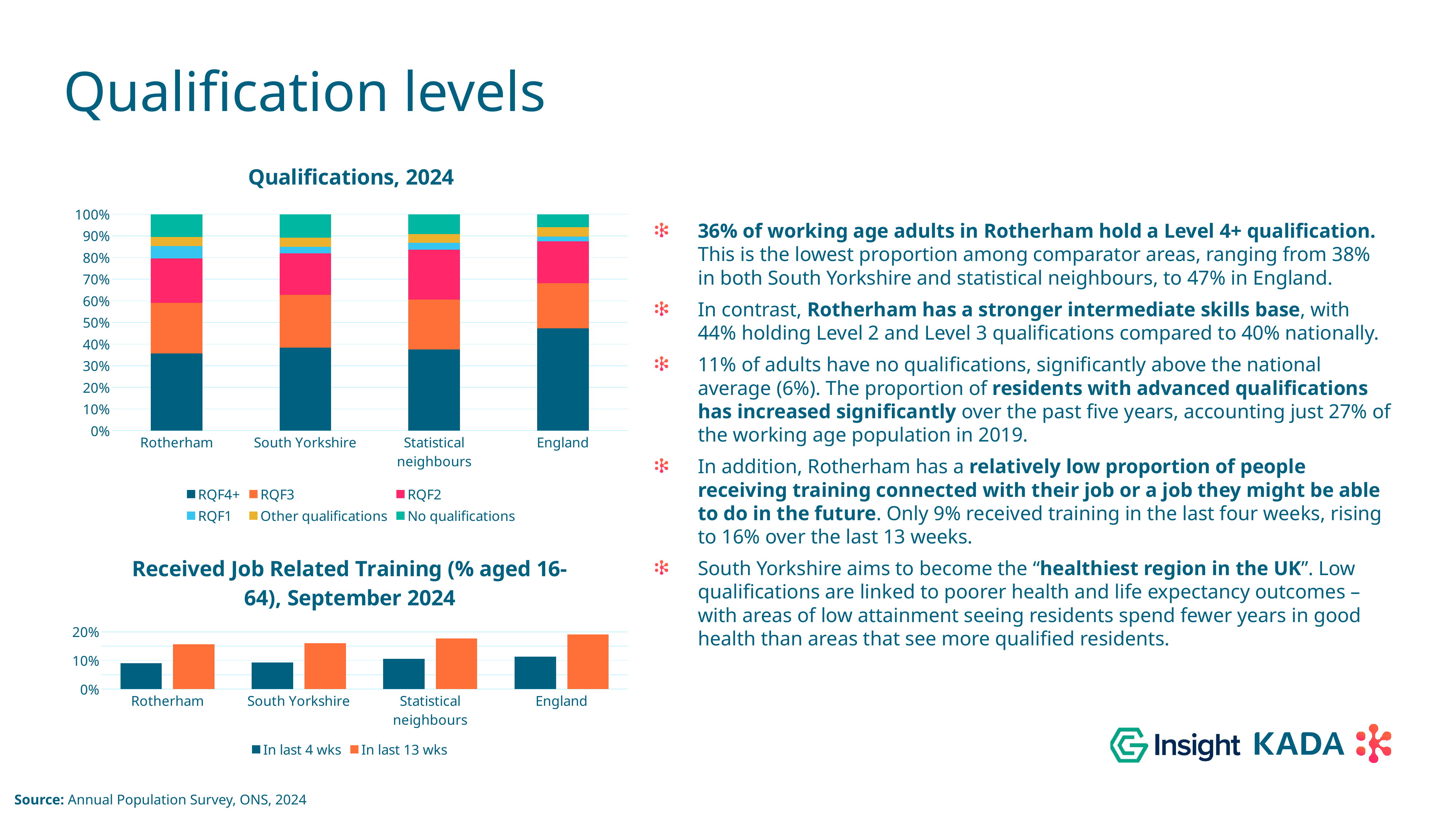
In the 'Received Job Related Training' chart, is the 'In last 4 wks' value for Rotherham greater or less than 10%? less In the 'Received Job Related Training' chart, do the 'In last 13 wks' values rise or fall from Rotherham to England? rise What kind of chart is the 'Qualifications, 2024' chart? stacked bar chart How many areas are shown on the x axis of the 'Qualifications, 2024' chart? 4 How many series does the legend of the 'Qualifications, 2024' chart list? 6 In the 'Qualifications, 2024' chart, what do the stacked segments of each bar add up to? 100% In the 'Qualifications, 2024' chart, which has the larger 'No qualifications' segment, Rotherham or England? Rotherham In the 'Qualifications, 2024' chart, is the RQF4+ value for England greater or less than 40%? greater In the 'Qualifications, 2024' chart, which area has the largest RQF4+ segment? England How many series does the legend of the 'Received Job Related Training' chart list? 2 In the 'Qualifications, 2024' chart, is the RQF4+ value for Rotherham greater or less than 40%? less In the 'Received Job Related Training' chart, which is larger for England, 'In last 4 wks' or 'In last 13 wks'? In last 13 wks